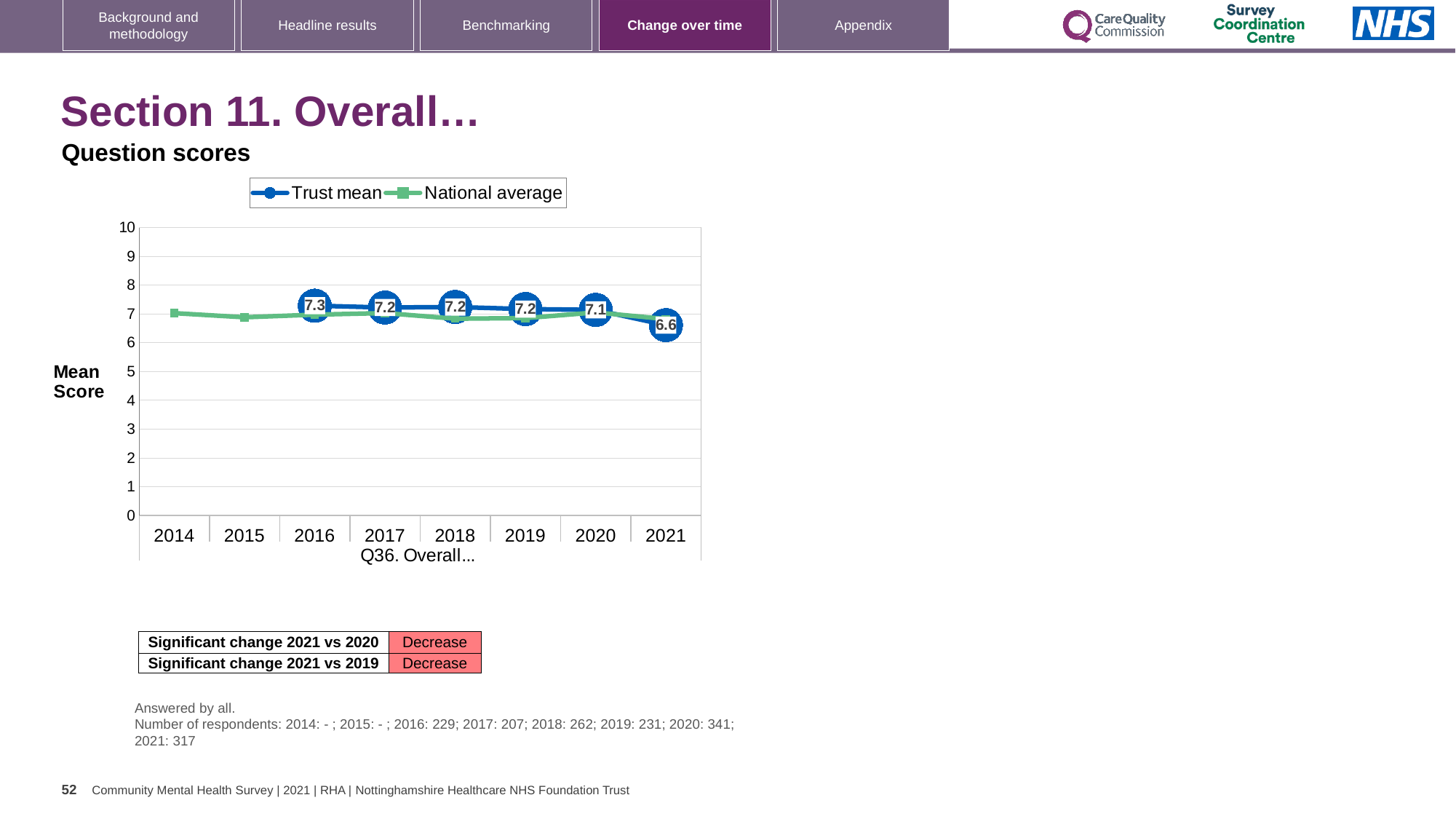
What kind of chart is shown? line chart Is the National average value for 2014 greater or less than 5? greater In which year is the Trust mean highest? 2016 What is the Trust mean value for 2016? 7.3 How many years are shown on the x axis? 8 What is the difference between the Trust mean in 2020 and in 2021? 0.5 What is the Trust mean value for 2021? 6.6 How many series does the legend list? 2 In which year is the Trust mean lowest? 2021 What is the difference between the Trust mean in 2016 and in 2021? 0.7 What is the Trust mean value for 2020? 7.1 Which is larger, the Trust mean in 2016 or in 2021? 2016